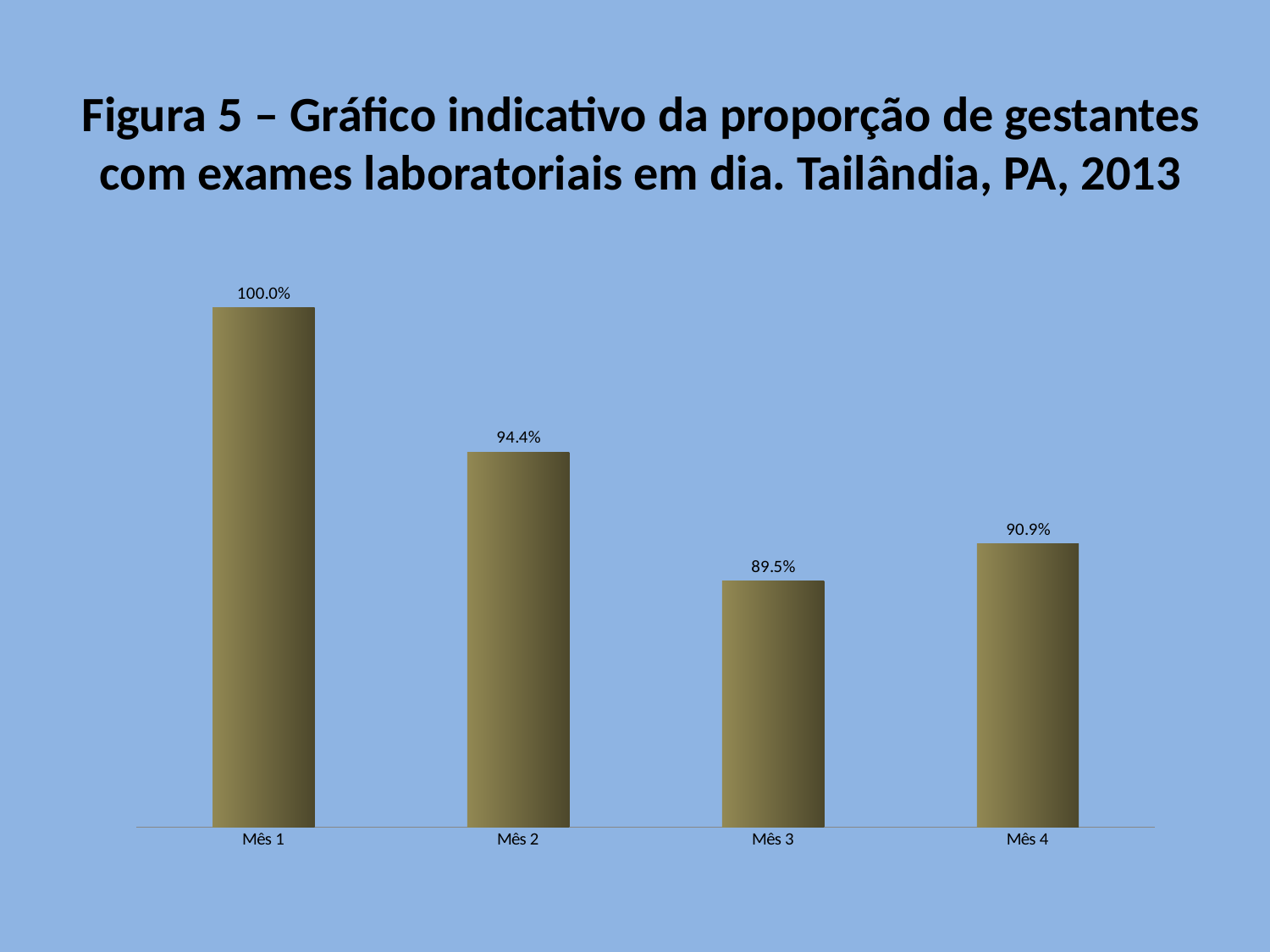
Which month has the lowest value? Mês 3 Do the values rise or fall from Mês 1 to Mês 3? Fall Which month has the highest value? Mês 1 How many months are shown on the x axis? 4 What is the difference between the values for Mês 4 and Mês 3? 1.4% What kind of chart is shown on the slide? Bar chart What is the difference between the values for Mês 1 and Mês 2? 5.6% What is the value for Mês 1? 100.0% What is the value for Mês 4? 90.9% What is the value for Mês 2? 94.4% What is the value for Mês 3? 89.5% Which is larger, the value for Mês 2 or the value for Mês 4? Mês 2